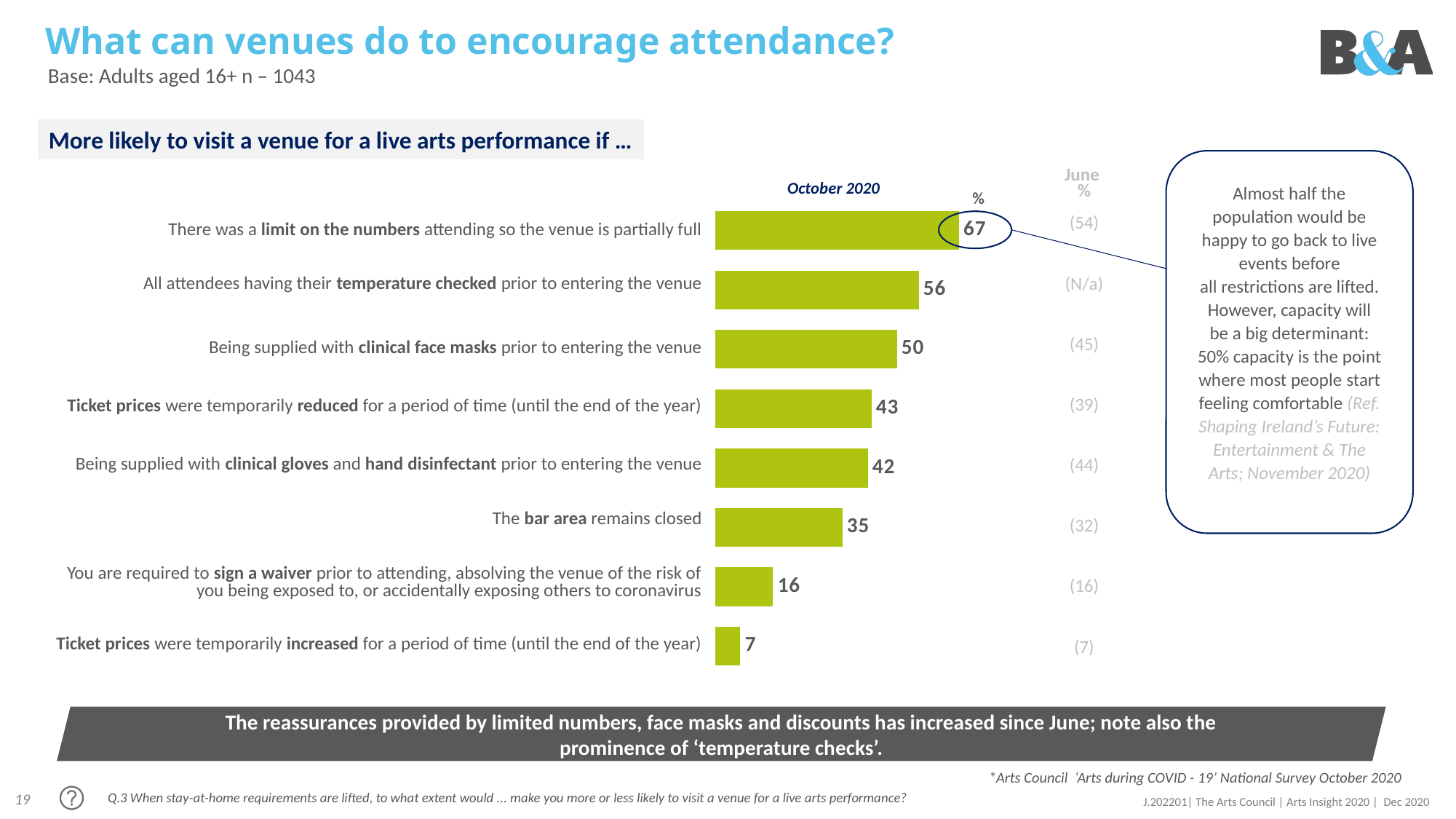
What is the title of the chart section above the bars? More likely to visit a venue for a live arts performance if … What is the October 2020 value for the bar area remaining closed? 35 Which category has the highest October 2020 value? There was a limit on the numbers attending so the venue is partially full What is the difference between the October 2020 values for being supplied with clinical face masks and being supplied with clinical gloves and hand disinfectant? 8 What was the June value for being supplied with clinical face masks prior to entering the venue? (45) What percentage of respondents said they would be more likely to visit a venue if there was a limit on the numbers attending so the venue is partially full (October 2020)? 67 What kind of chart is used on this slide? Bar chart Which category has the lowest October 2020 value? Ticket prices were temporarily increased for a period of time (until the end of the year) How many categories are shown in the bar chart? 8 What is the difference between the October 2020 and June values for a limit on the numbers attending? 13 What is the October 2020 value for all attendees having their temperature checked prior to entering the venue? 56 Which has a higher October 2020 value: ticket prices temporarily reduced or the bar area remaining closed? Ticket prices were temporarily reduced